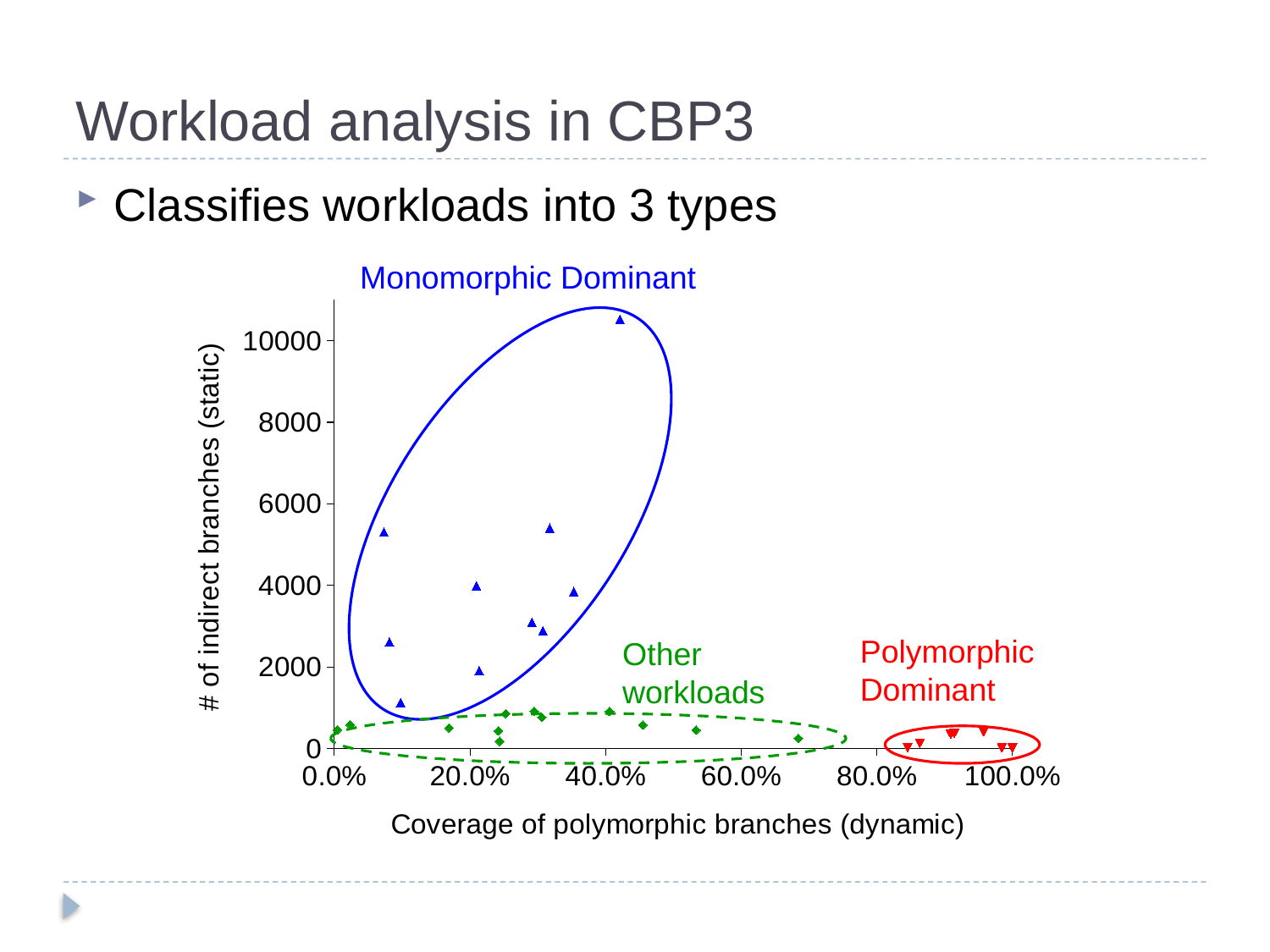
What is the label of the x axis of the chart? Coverage of polymorphic branches (dynamic) What is the highest value shown on the y axis? 10000 Are the Polymorphic Dominant points at a coverage greater or less than 80.0%? greater Which workload group has the highest coverage of polymorphic branches? Polymorphic Dominant Are the Other workloads points greater or less than 2000 indirect branches? less How many workload types does the chart classify workloads into? 3 What kind of chart is shown on the slide? scatter chart Which group has more indirect branches overall, Monomorphic Dominant or Polymorphic Dominant? Monomorphic Dominant Which workload group contains the point with the highest number of indirect branches? Monomorphic Dominant What is the label of the y axis of the chart? # of indirect branches (static) Is the highest Monomorphic Dominant point greater or less than 10000 indirect branches? greater